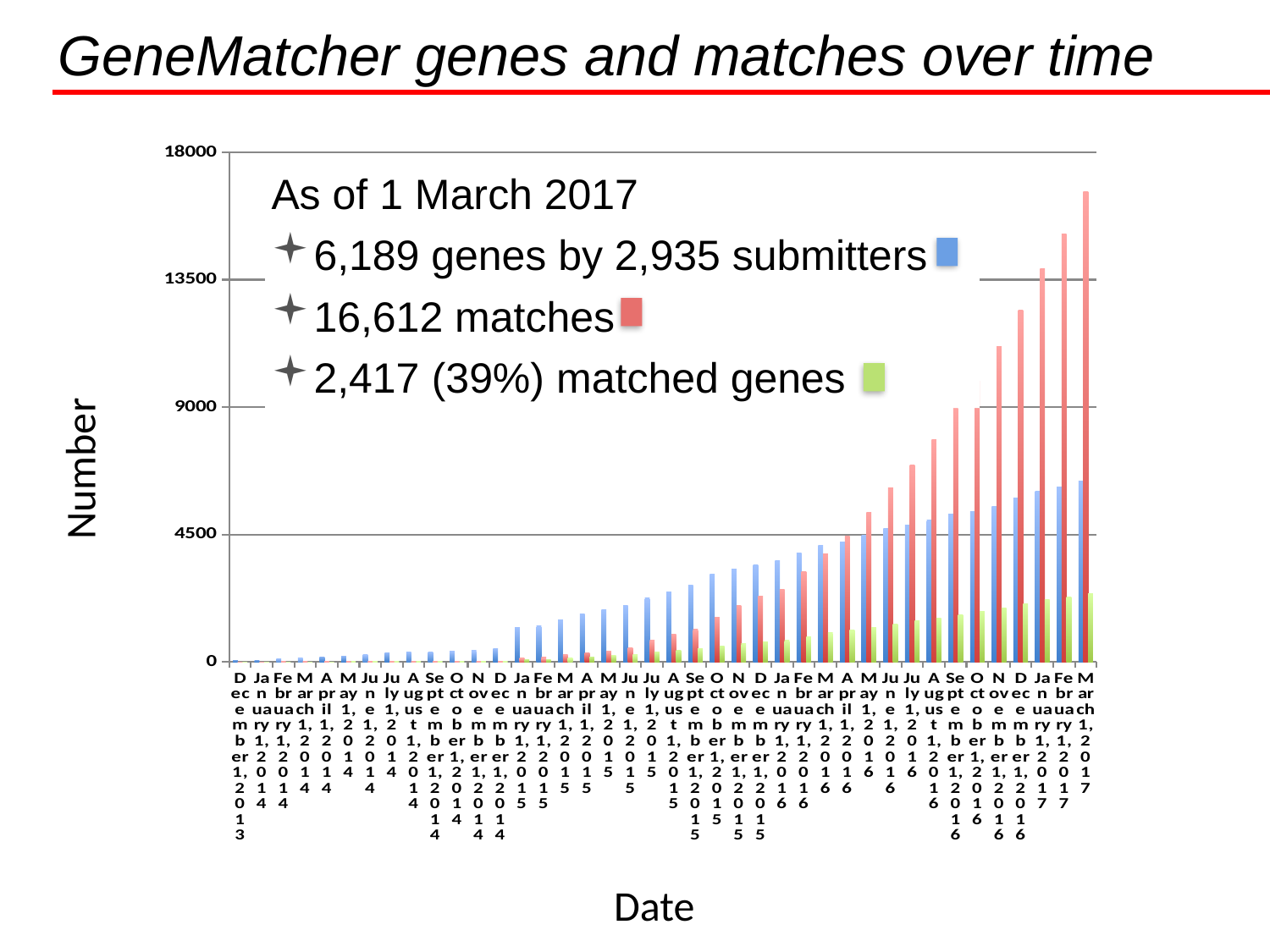
What is the title of the chart on the slide? GeneMatcher genes and matches over time Is the value of the red (matches) bar for March 2017 greater or less than 13500? greater According to the annotation, how many genes were there as of 1 March 2017? 6,189 Is the value of the green (matched genes) bar for March 2017 greater or less than 4500? less What kind of chart is shown on the slide? bar chart According to the annotation, how many matches were there as of 1 March 2017? 16,612 What percentage of genes were matched as of 1 March 2017? 39% According to the annotation, how many matched genes were there as of 1 March 2017? 2,417 What is the difference between the number of matches and the number of genes as of 1 March 2017? 10,423 Do the values of the matches series rise or fall over time along the x axis? rise How many series does the chart plot (as indicated by the coloured squares in the annotation)? 3 In March 2017, which is larger: the number of matches (red) or the number of genes (blue)? matches